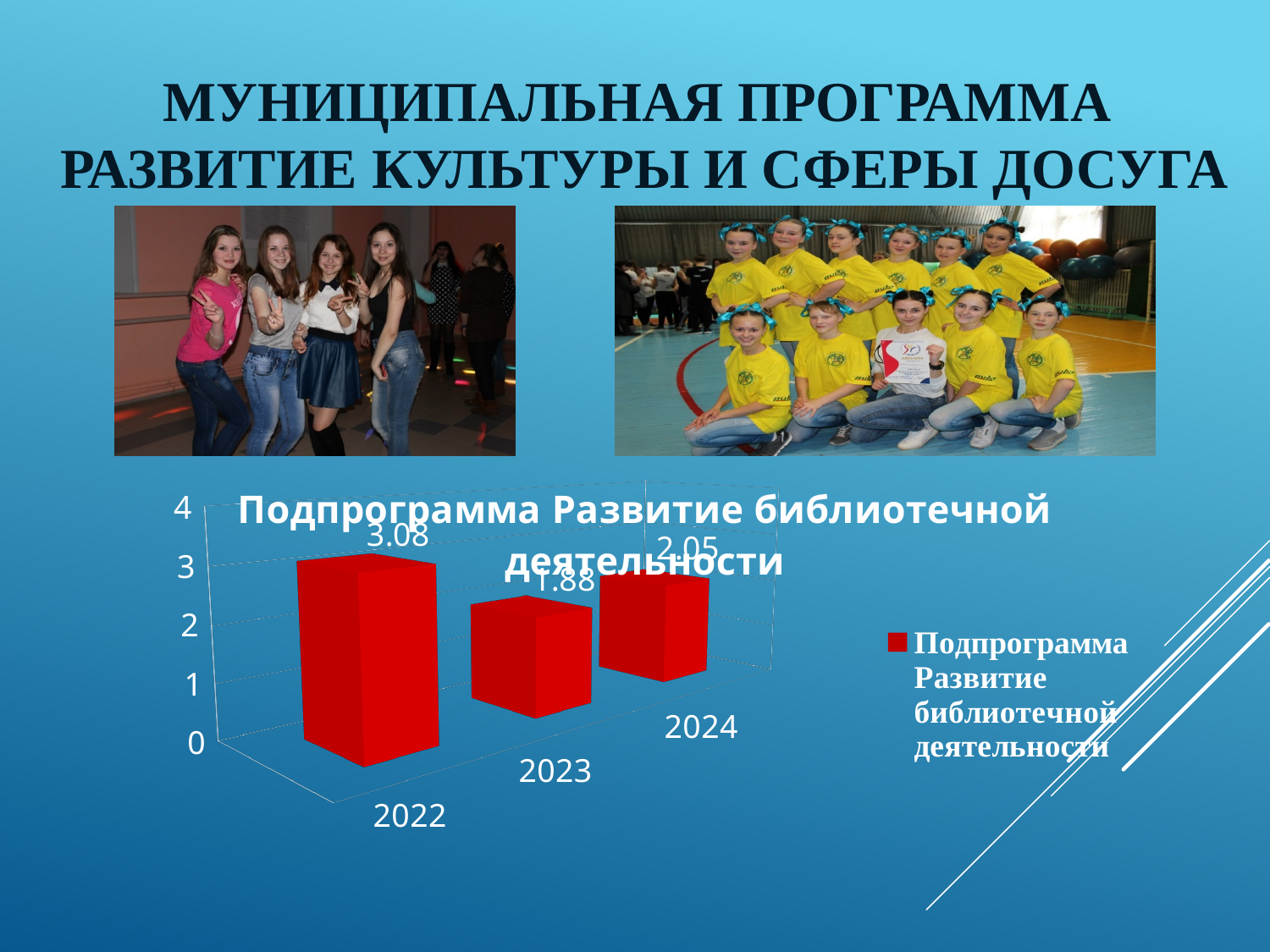
What kind of chart is shown on the slide? bar chart What is the title of the chart? Подпрограмма Развитие библиотечной деятельности Which year has the lowest value in the chart? 2023 How many years are shown on the x axis of the chart? 3 What is the value for 2022 in the chart? 3.08 Which is larger, the value for 2022 or the value for 2024? 2022 What is the difference between the values for 2024 and 2023? 0.17 What is the difference between the values for 2022 and 2023? 1.20 Which year has the highest value in the chart? 2022 What is the value for 2024 in the chart? 2.05 Is the value for 2022 greater or less than 3? greater What is the value for 2023 in the chart? 1.88